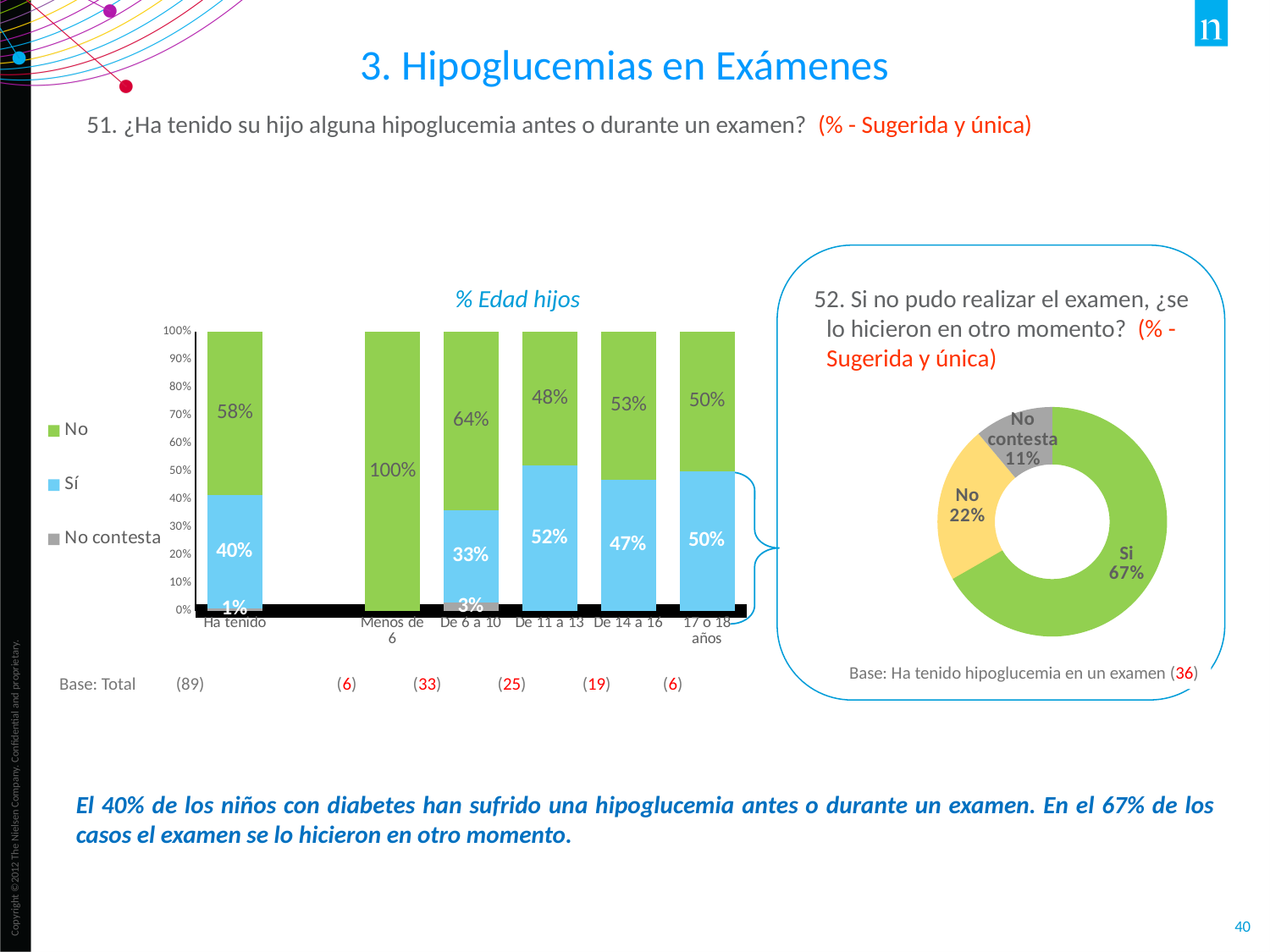
How many series does the legend of the stacked bar chart '% Edad hijos' list? 3 How many categories are shown on the x axis of the stacked bar chart '% Edad hijos'? 6 In the stacked bar chart '% Edad hijos', which age group has the highest 'Sí' value? De 11 a 13 What kind of chart is used for question 52 on the right of the slide? Donut (pie) chart In the donut chart for question 52, which slice is the smallest? No contesta In the stacked bar chart '% Edad hijos', what is the 'No contesta' value for 'Ha tenido'? 1% In the stacked bar chart '% Edad hijos', what is the 'No' value for 'De 6 a 10'? 64% In the stacked bar chart '% Edad hijos', what is the difference between the 'No' and 'Sí' values for 'Ha tenido'? 18% In the donut chart for question 52, what share is 'Si'? 67% In the stacked bar chart '% Edad hijos', which category has the highest 'No' value? Menos de 6 In the stacked bar chart '% Edad hijos', what is the 'Sí' value for 'De 11 a 13'? 52% In the stacked bar chart '% Edad hijos', is the 'Sí' value larger for 'De 6 a 10' or for 'De 14 a 16'? De 14 a 16